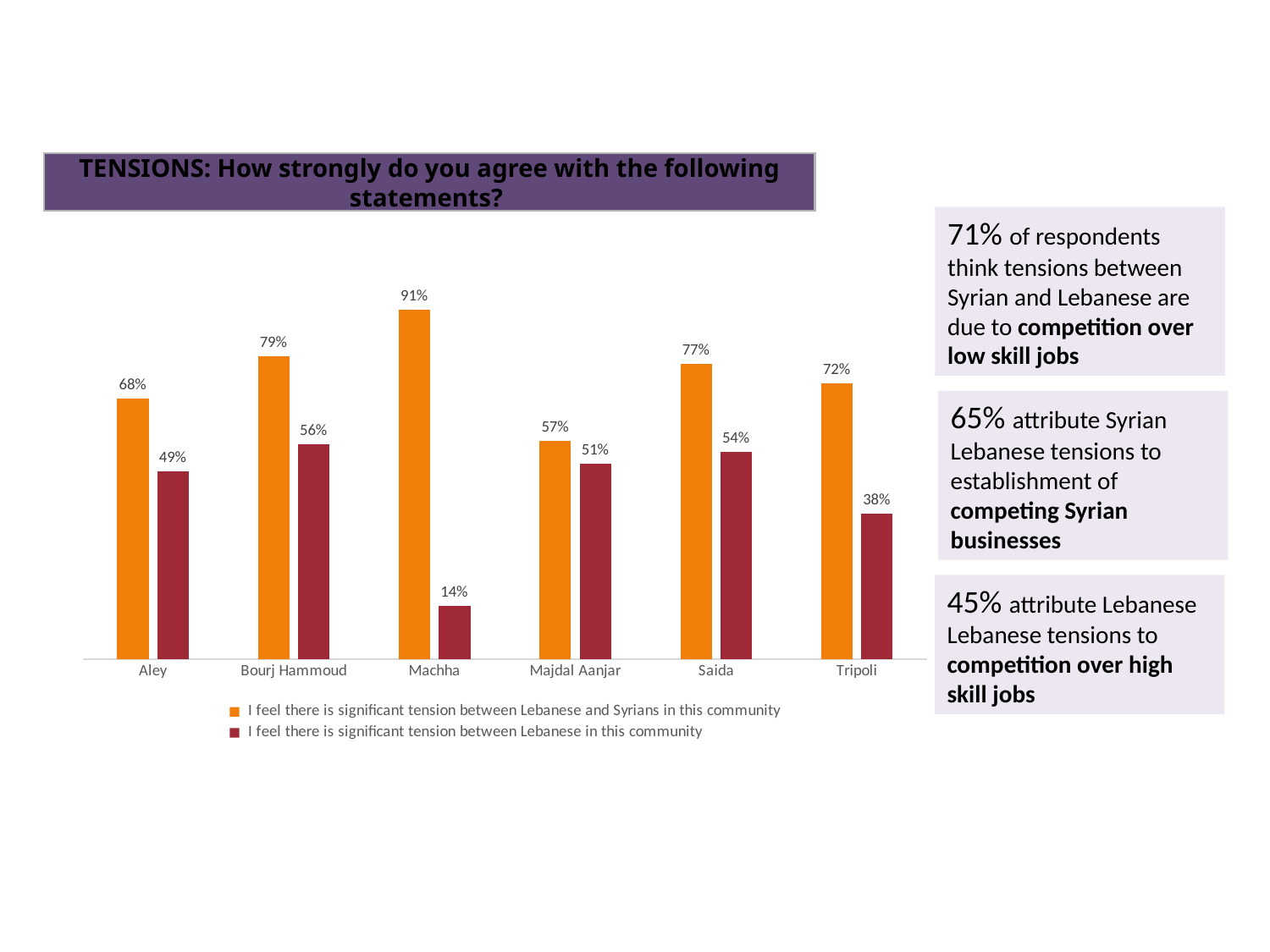
How many communities are shown on the x axis of the chart? 6 What kind of chart is shown on the slide? Bar chart What percentage of respondents in Machha feel there is significant tension between Lebanese and Syrians in this community? 91% Which is larger: the Lebanese-Lebanese tension value for Bourj Hammoud or for Majdal Aanjar? Bourj Hammoud What is the difference between the two series values for Machha? 77% What colour are the bars for 'I feel there is significant tension between Lebanese in this community'? Dark red What is the difference between the Lebanese-Syrian tension values for Saida and Aley? 9% Which community has the lowest value for 'I feel there is significant tension between Lebanese and Syrians in this community'? Majdal Aanjar How many series does the chart legend list? 2 What percentage of respondents in Tripoli feel there is significant tension between Lebanese in this community? 38% Which community has the highest value for 'I feel there is significant tension between Lebanese and Syrians in this community'? Machha Which community has the lowest value for 'I feel there is significant tension between Lebanese in this community'? Machha